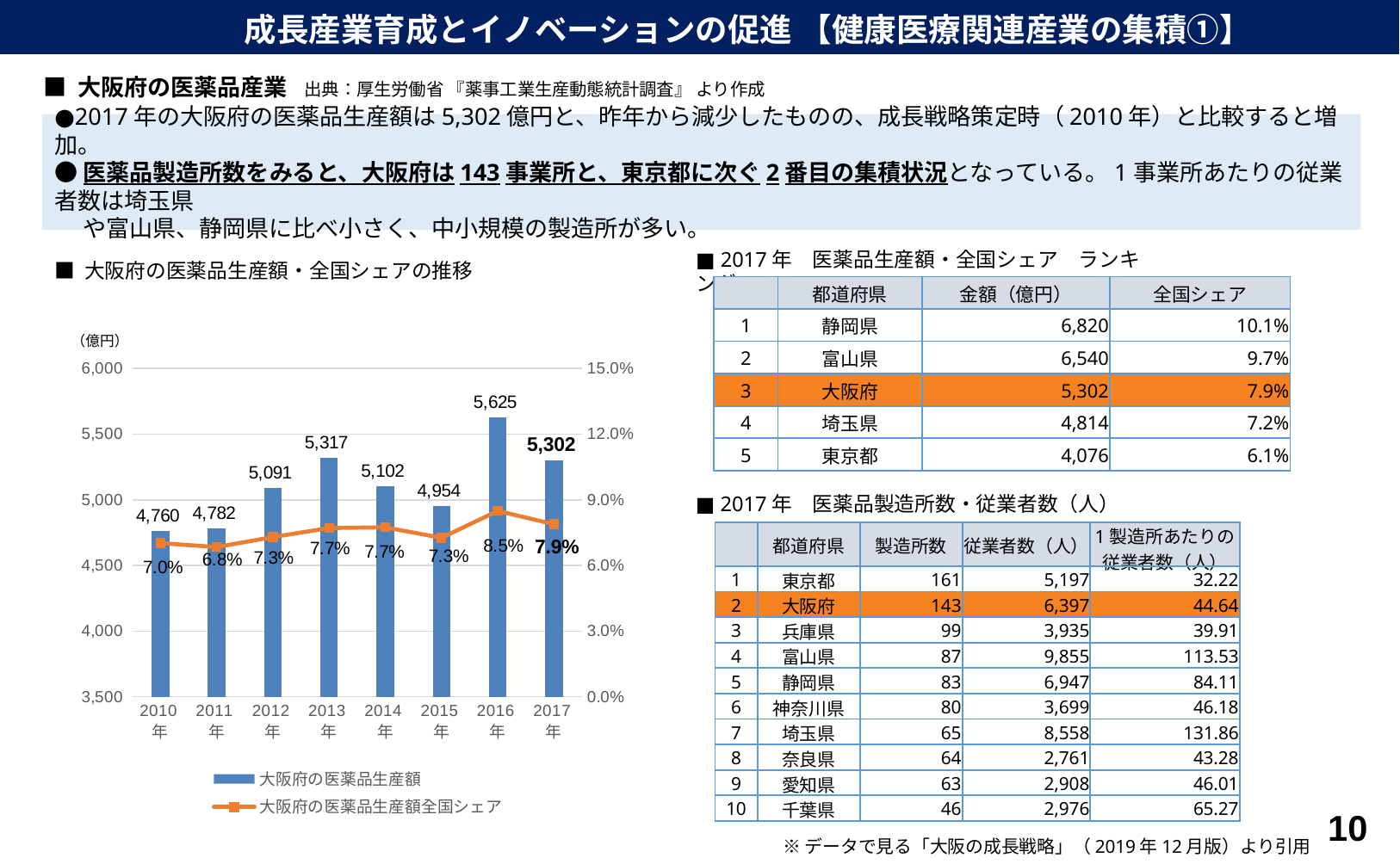
What is the difference between the 大阪府の医薬品生産額 for 2016年 and 2017年? 323 What kind of chart is 大阪府の医薬品生産額・全国シェアの推移? Combined bar and line chart What is the value of 大阪府の医薬品生産額 for 2010年 in the chart? 4,760 Which year has the lowest 大阪府の医薬品生産額全国シェア in the chart? 2011年 Which year has the highest 大阪府の医薬品生産額 in the chart? 2016年 Which is larger, the 大阪府の医薬品生産額 for 2013年 or for 2014年? 2013年 How many years are shown on the x axis of the chart? 8 What is the 大阪府の医薬品生産額全国シェア for 2011年 in the chart? 6.8% How many series does the legend of the chart list? 2 What is the 大阪府の医薬品生産額全国シェア for 2017年 in the chart? 7.9% What is the value of 大阪府の医薬品生産額 for 2016年 in the chart 大阪府の医薬品生産額・全国シェアの推移? 5,625 Does the 大阪府の医薬品生産額 rise or fall from 2014年 to 2015年? Fall